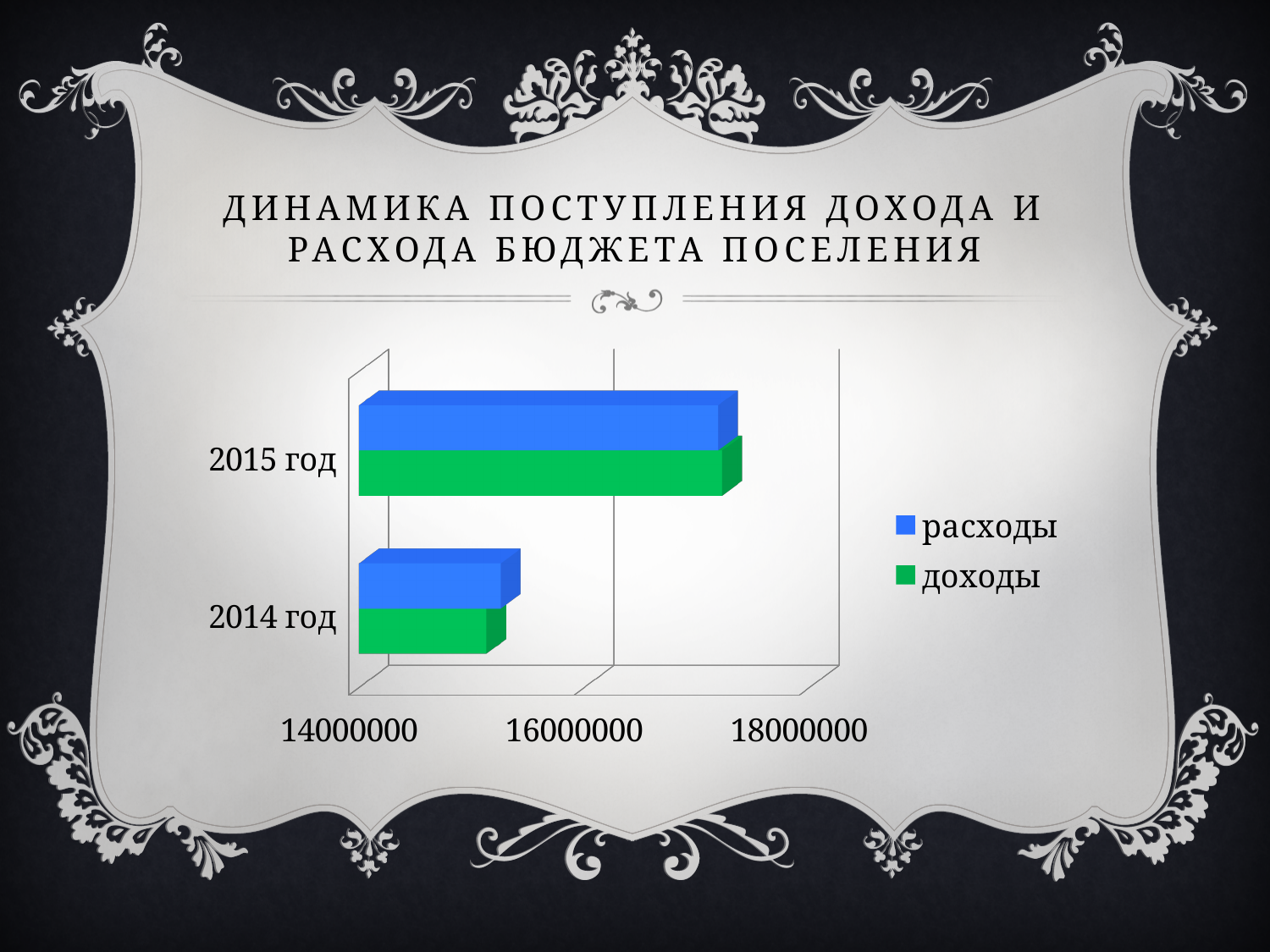
Is the value of расходы for 2015 год greater or less than 18000000? less Is the value of доходы for 2015 год greater or less than 16000000? greater Is the value of доходы for 2014 год greater or less than 16000000? less Do the values of доходы rise or fall from 2014 год to 2015 год? rise Which year has the higher value of расходы? 2015 год Which year has the lower value of доходы? 2014 год How many year categories are plotted on the chart? 2 What kind of chart is shown on the slide? bar chart Which colour represents the series доходы in the legend? green How many series does the legend list? 2